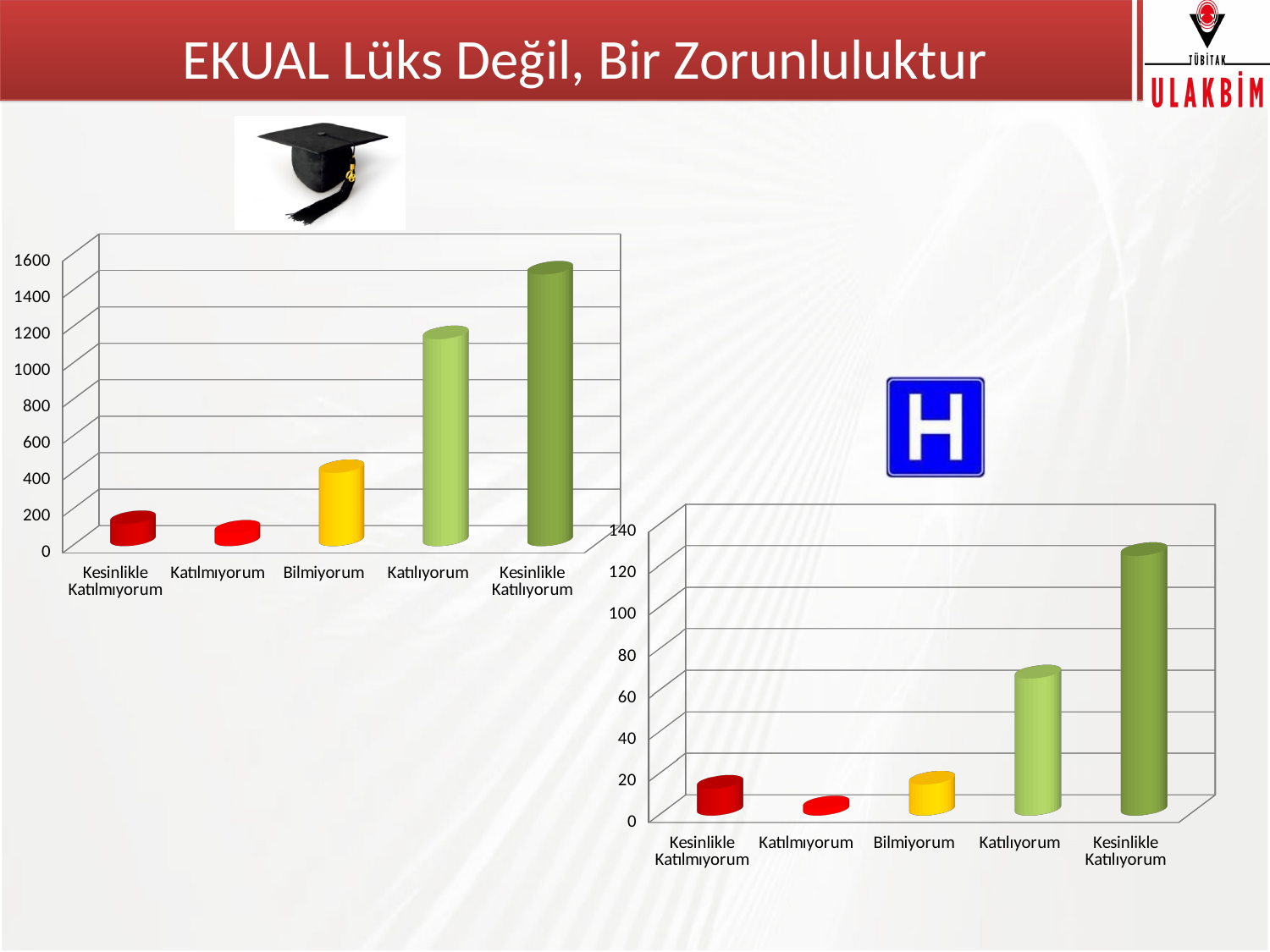
In the chart on the right, which category has the highest value? Kesinlikle Katılıyorum What kind of chart is the chart on the left of the slide? bar chart In the chart on the right, which category has the lowest value? Katılmıyorum In the chart on the left, is the value for Kesinlikle Katılıyorum greater or less than 1200? greater In the chart on the right, which is larger, the value for Katılıyorum or the value for Bilmiyorum? Katılıyorum How many categories are shown on the x axis of the chart on the right of the slide? 5 In the chart on the left, which category has the lowest value? Katılmıyorum In the chart on the left, which is larger, the value for Bilmiyorum or the value for Kesinlikle Katılmıyorum? Bilmiyorum In the chart on the right, is the value for Kesinlikle Katılıyorum greater or less than 100? greater In the chart on the left, is the value for Bilmiyorum greater or less than 600? less In the chart on the left, which category has the highest value? Kesinlikle Katılıyorum